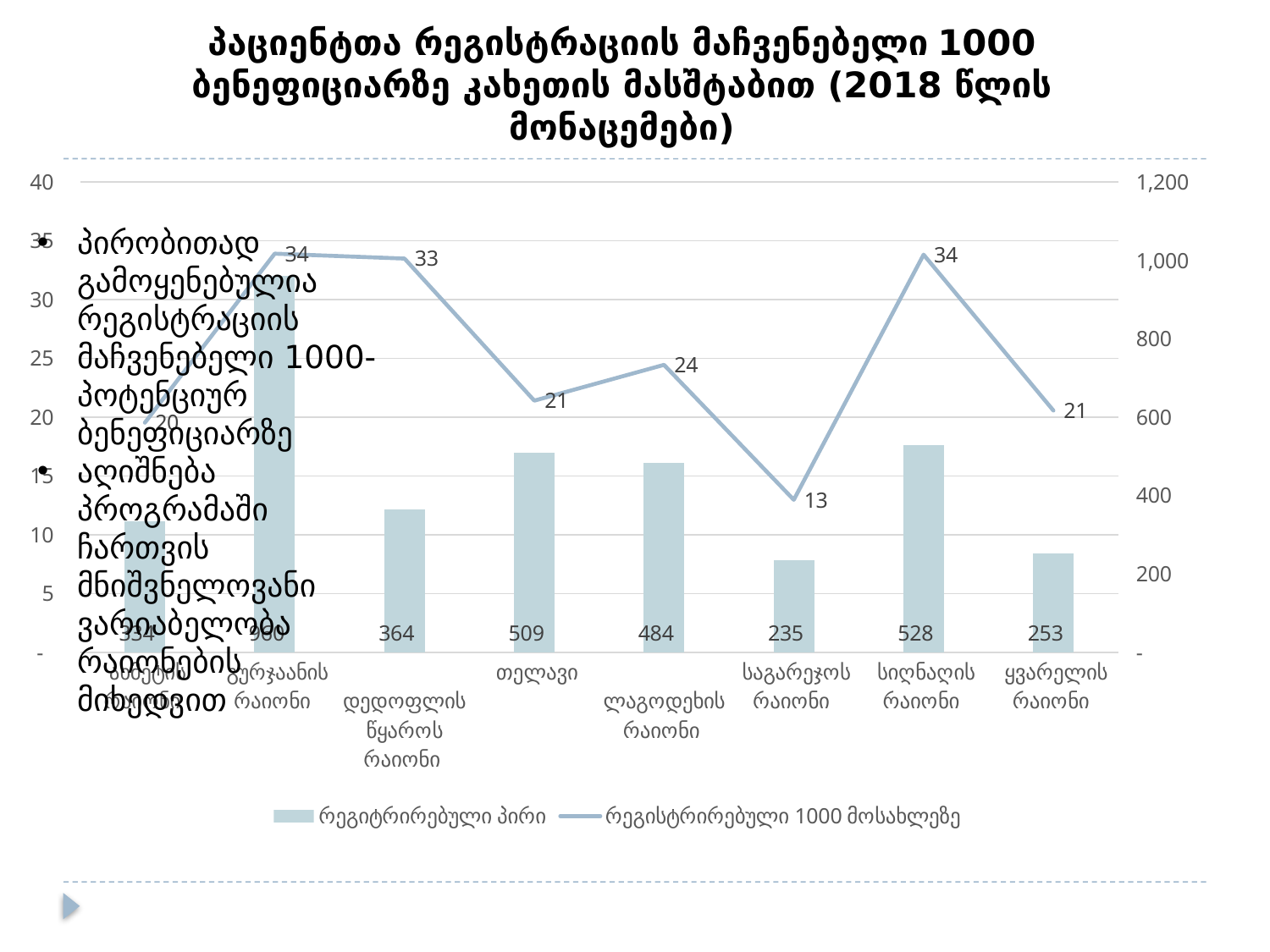
What kind of chart is shown on the slide? Combination bar and line chart Is the value of რეგისტრირებული 1000 მოსახლეზე for დედოფლის წყაროს რაიონი greater or less than 30? greater What is the value of რეგიტრირებული პირი for თელავი? 509 What is the value of რეგიტრირებული პირი for სიღნაღის რაიონი? 528 What is the difference between the რეგიტრირებული პირი values for სიღნაღის რაიონი and საგარეჯოს რაიონი? 293 What is the value of რეგისტრირებული 1000 მოსახლეზე for ლაგოდეხის რაიონი? 24 How many categories are shown on the x axis? 8 What is the value of რეგისტრირებული 1000 მოსახლეზე for საგარეჯოს რაიონი? 13 How many series does the legend list? 2 Which category has the lowest value of რეგისტრირებული 1000 მოსახლეზე? საგარეჯოს რაიონი Which category has the lowest value of რეგიტრირებული პირი? საგარეჯოს რაიონი Which has a higher რეგიტრირებული პირი value, თელავი or ლაგოდეხის რაიონი? თელავი